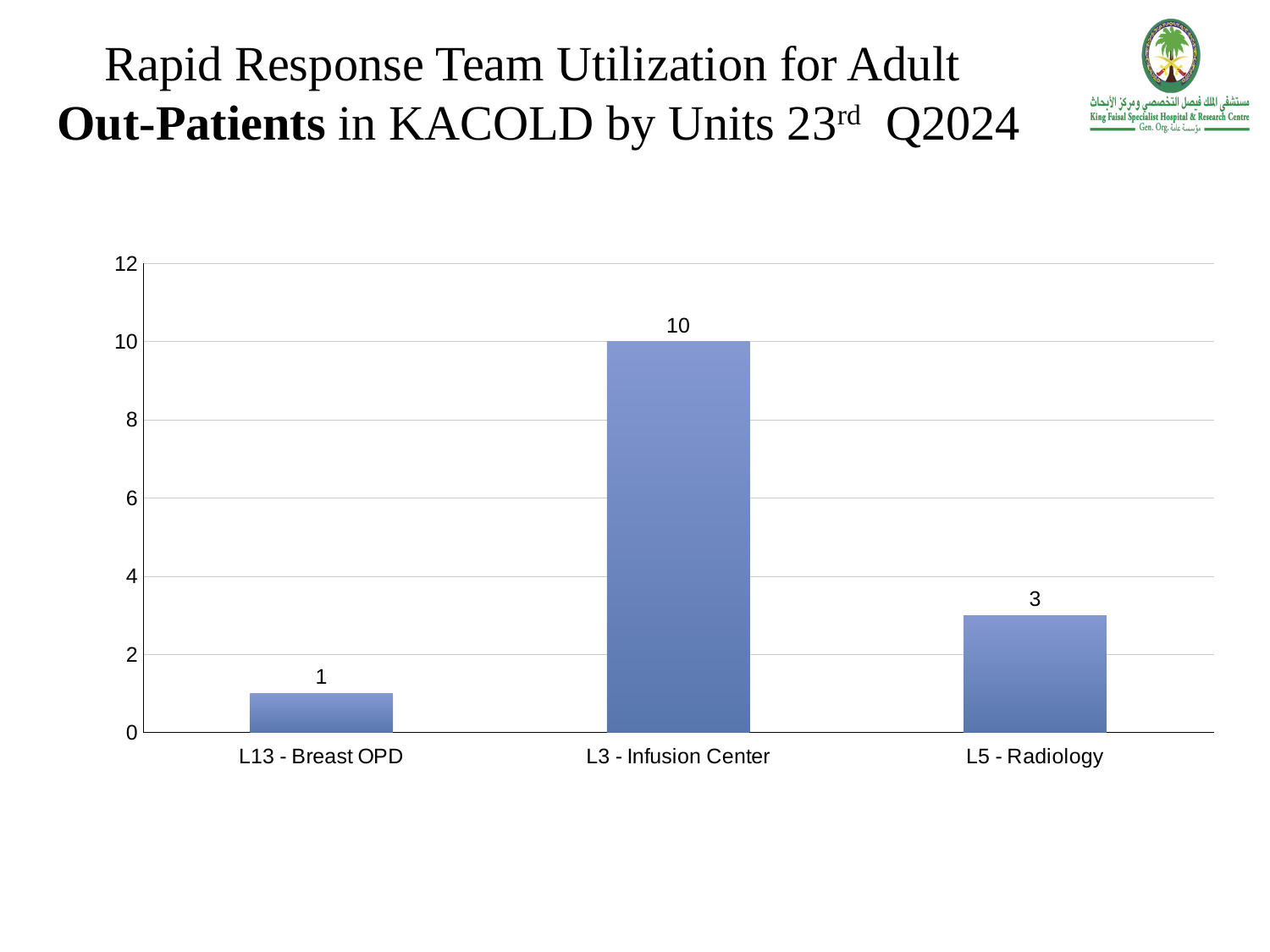
Which unit has the highest value? L3 - Infusion Center What is the highest value shown on the vertical axis? 12 What is the value for L5 - Radiology? 3 Which unit has the lowest value? L13 - Breast OPD What is the value for L3 - Infusion Center? 10 What is the difference between the values for L3 - Infusion Center and L5 - Radiology? 7 Is the value for L3 - Infusion Center greater or less than 8? greater What is the difference between the values for L5 - Radiology and L13 - Breast OPD? 2 How many units are shown on the chart? 3 Which is larger, the value for L5 - Radiology or the value for L13 - Breast OPD? L5 - Radiology What kind of chart is shown on the slide? bar chart What is the value for L13 - Breast OPD? 1